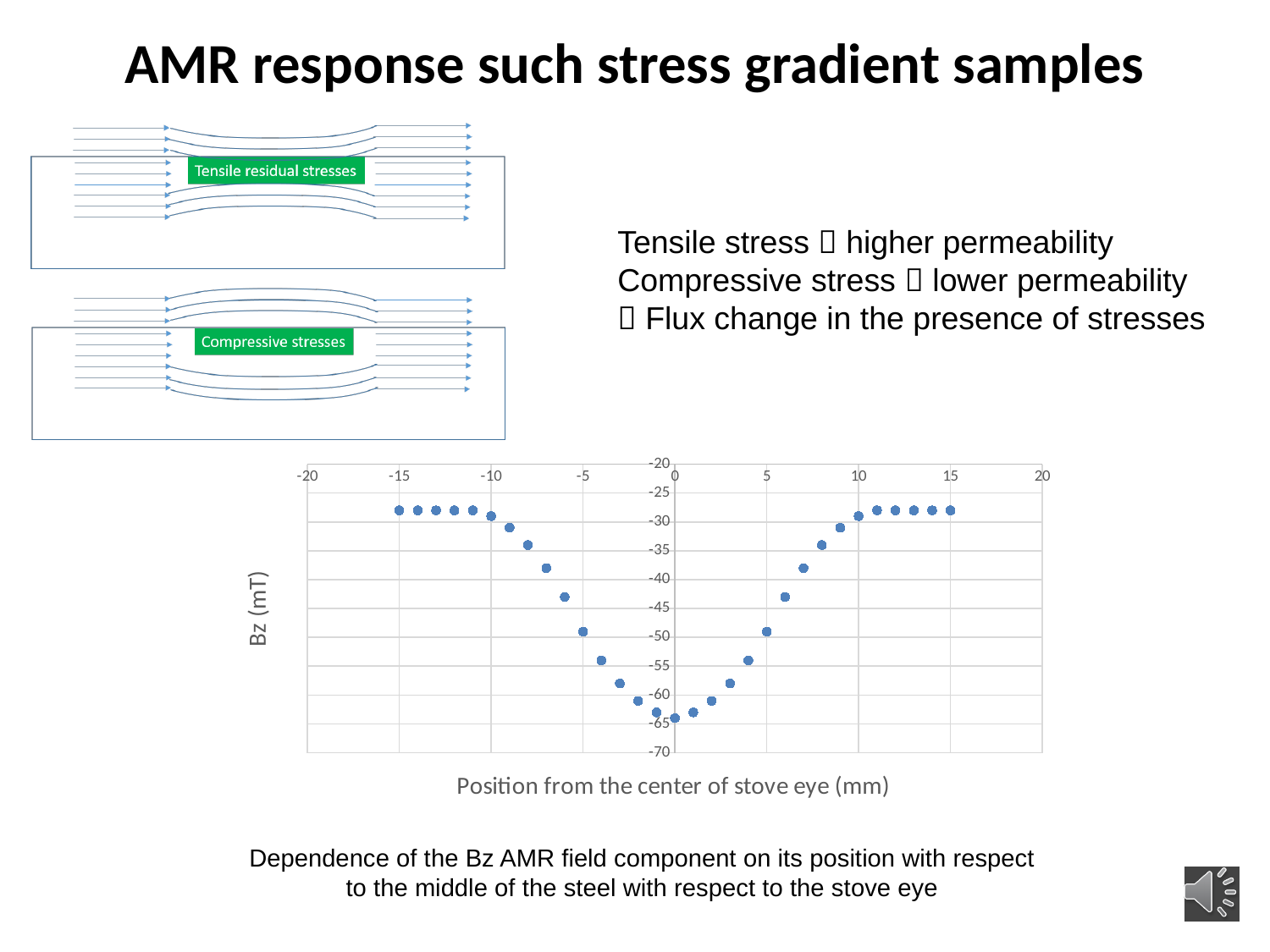
Is the Bz value at position -15 mm greater or less than -30? greater Which has the larger Bz value: position -10 mm or position -5 mm? -10 mm Around which position on the x axis does Bz reach its lowest value? 0 What is the title of the y axis of the chart? Bz (mT) Which has the larger Bz value: position -15 mm or position 0 mm? -15 mm Is the Bz value at position 0 mm greater or less than -60? less Is the Bz value at position -7 mm greater or less than -35? less Do the Bz values rise or fall as the position goes from -10 mm to 0 mm? fall What kind of chart is shown on the slide? scatter chart What is the title of the x axis of the chart? Position from the center of stove eye (mm)